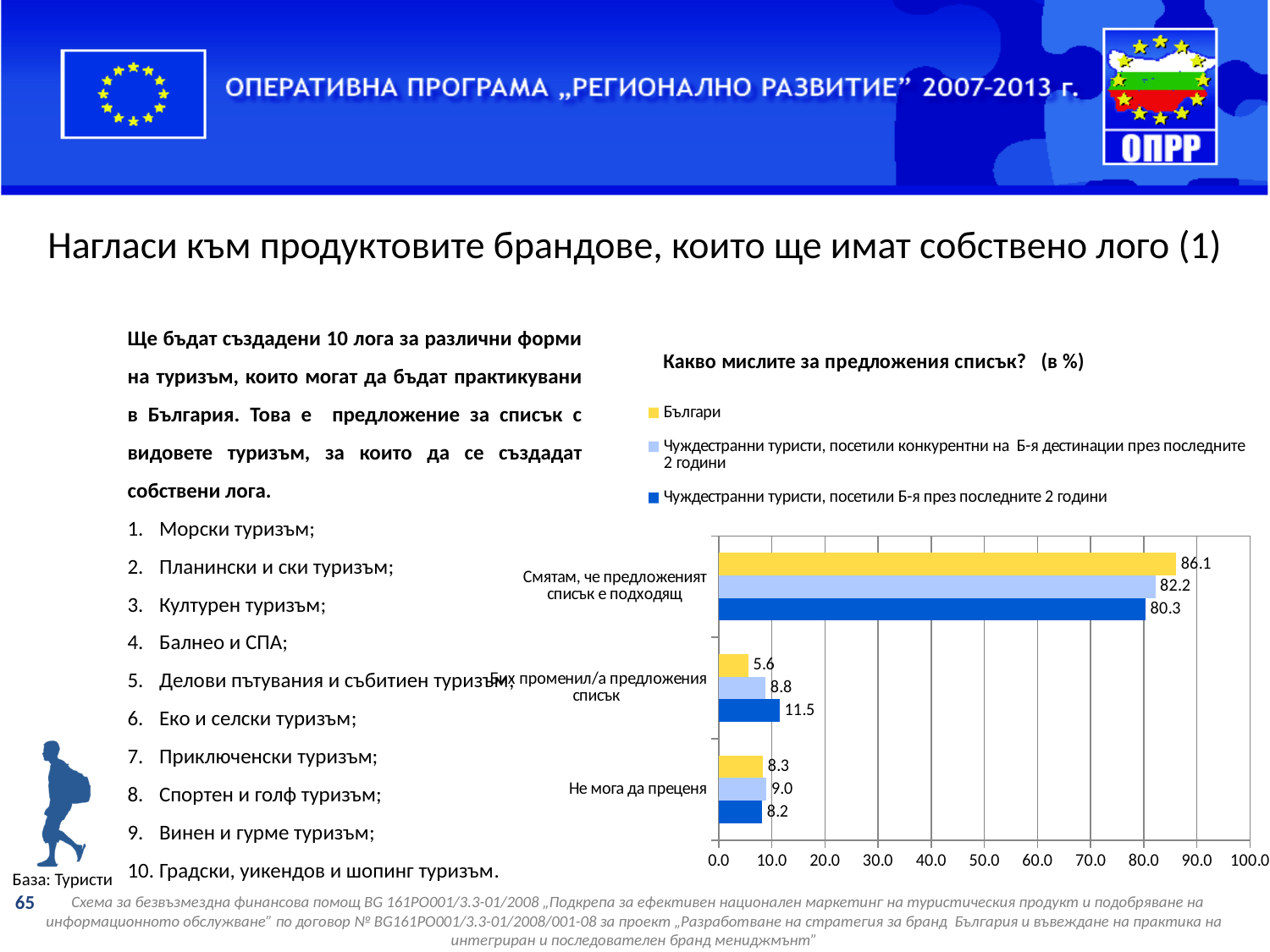
What type of chart is shown on the slide? bar chart How many series does the chart legend list? 3 What is the difference between the Българи value and the "Чуждестранни туристи, посетили Б-я през последните 2 години" value in the category "Смятам, че предложеният списък е подходящ"? 5.8 Which series has the highest value in the category "Смятам, че предложеният списък е подходящ"? Българи What is the value for Българи in the category "Смятам, че предложеният списък е подходящ"? 86.1 Is the value for Българи in the category "Смятам, че предложеният списък е подходящ" greater or less than 80.0? greater How many categories are shown on the chart's vertical axis? 3 Which series has the lowest value in the category "Бих променил/а предложения списък"? Българи What is the value for "Чуждестранни туристи, посетили конкурентни на Б-я дестинации през последните 2 години" in the category "Не мога да преценя"? 9.0 What is the value for "Чуждестранни туристи, посетили Б-я през последните 2 години" in the category "Бих променил/а предложения списък"? 11.5 In the category "Бих променил/а предложения списък", which is larger: the value for Българи or the value for "Чуждестранни туристи, посетили Б-я през последните 2 години"? Чуждестранни туристи, посетили Б-я през последните 2 години What is the title of the chart? Какво мислите за предложения списък? (в %)